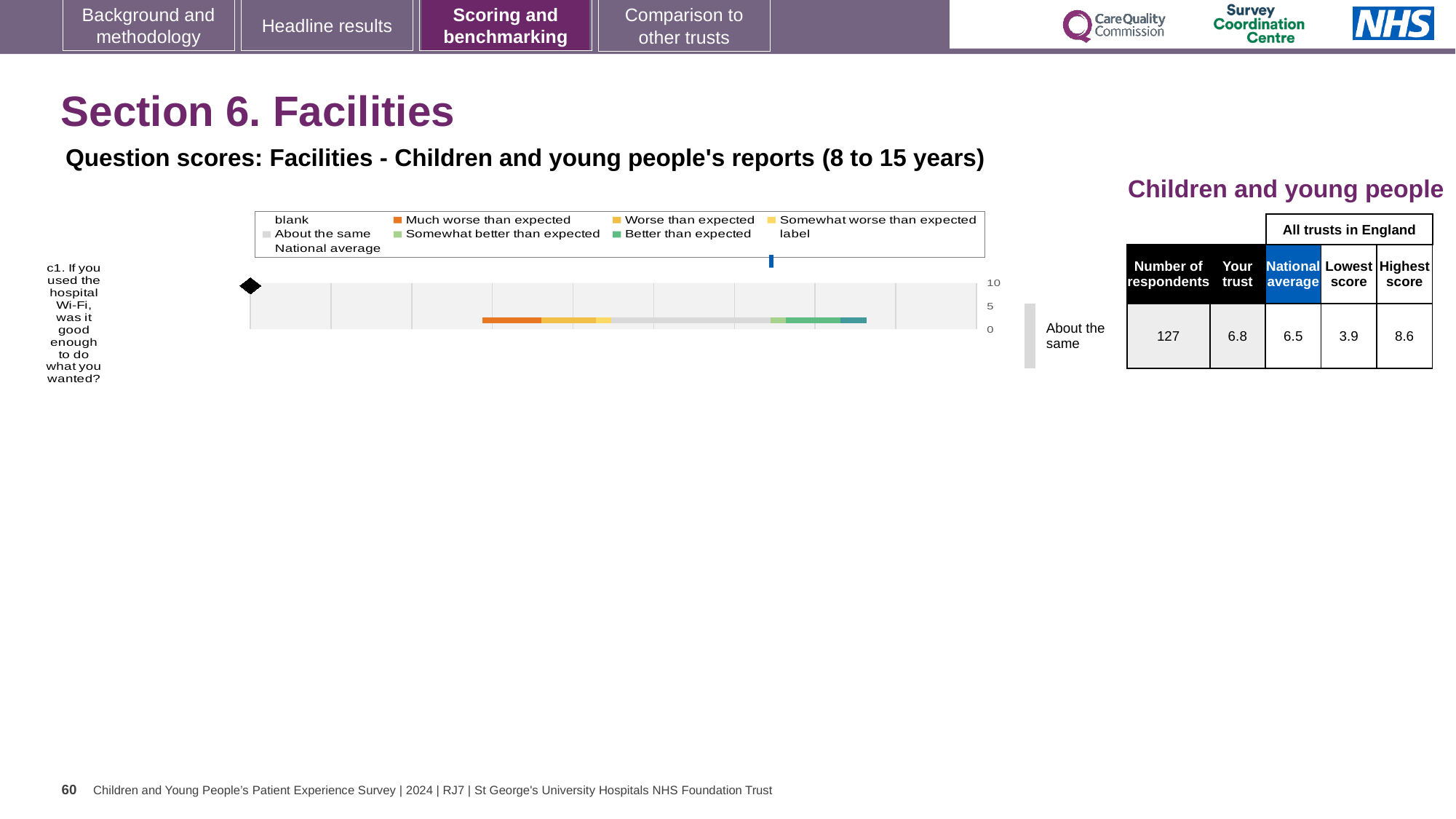
Which is larger for question c1: the trust's score or the national average? Your trust How many respondents answered question c1 about the hospital Wi-Fi? 127 What is the highest score among all trusts in England for question c1? 8.6 What is the lowest score among all trusts in England for question c1? 3.9 What kind of chart is used to show the question score for c1 about hospital Wi-Fi? Bar chart What is the maximum value shown on the chart's axis? 10 What is the difference between the highest score and the lowest score for question c1? 4.7 What benchmark category is the trust's score for question c1 placed in? About the same What is the national average score for question c1 about the hospital Wi-Fi? 6.5 Which legend entry is shown in orange on the chart? Much worse than expected What is the 'Your trust' score for question c1 about the hospital Wi-Fi? 6.8 How many questions (categories) are plotted on the chart? 1